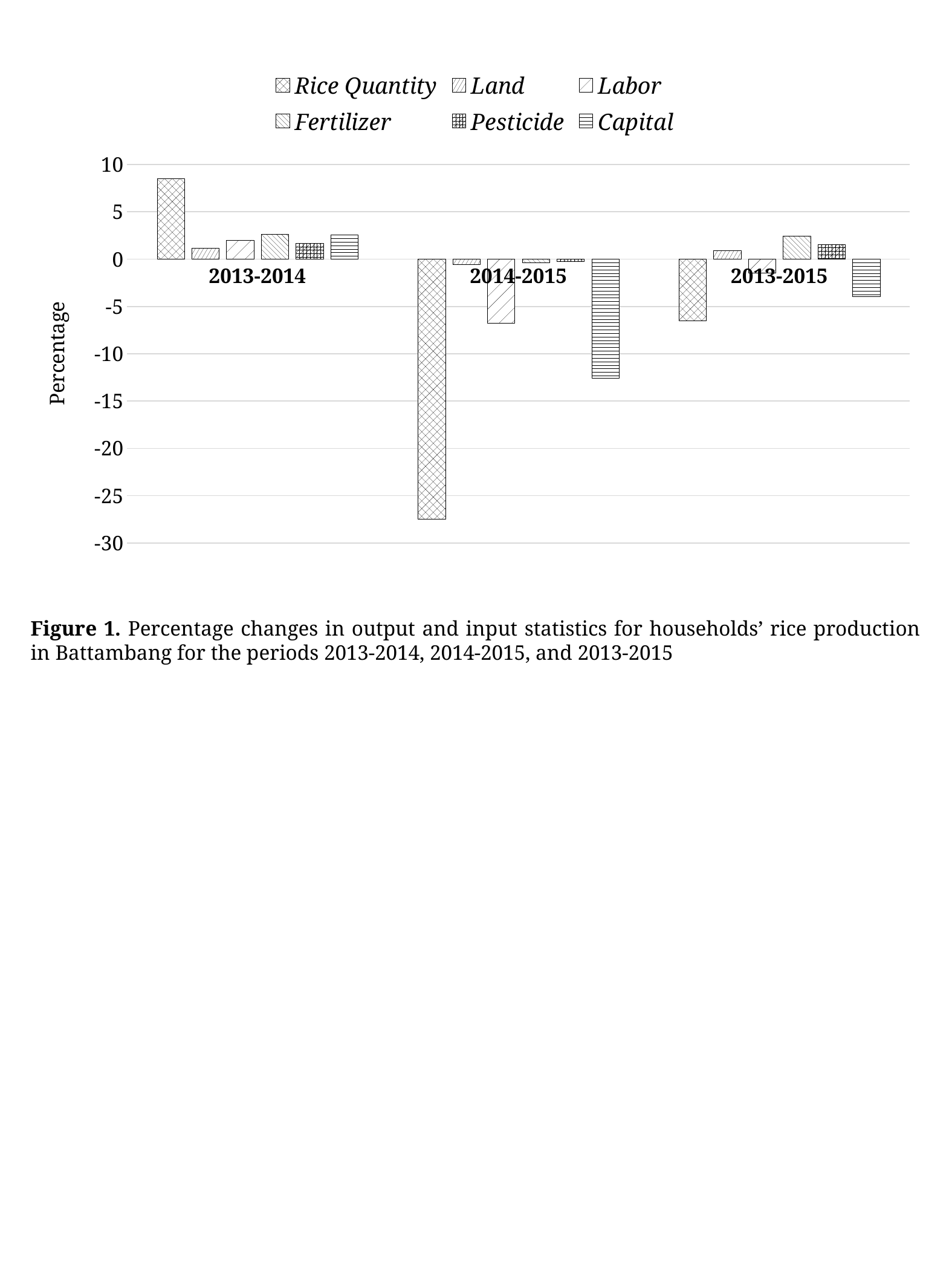
Which series has the highest value in the 2013-2014 period? Rice Quantity How many periods are shown on the x axis? 3 What kind of chart is shown on the slide? Bar chart Is the value for Rice Quantity in 2014-2015 greater or less than -25? less In the 2014-2015 period, which is lower: Labor or Capital? Capital Is the value for Labor in 2014-2015 greater or less than -5? less Is the value for Rice Quantity in 2013-2014 greater or less than 5? greater What is the label on the vertical axis? Percentage How many series does the legend list? 6 Which series has the lowest value in the 2013-2015 period? Rice Quantity Which series has the lowest value in the 2014-2015 period? Rice Quantity